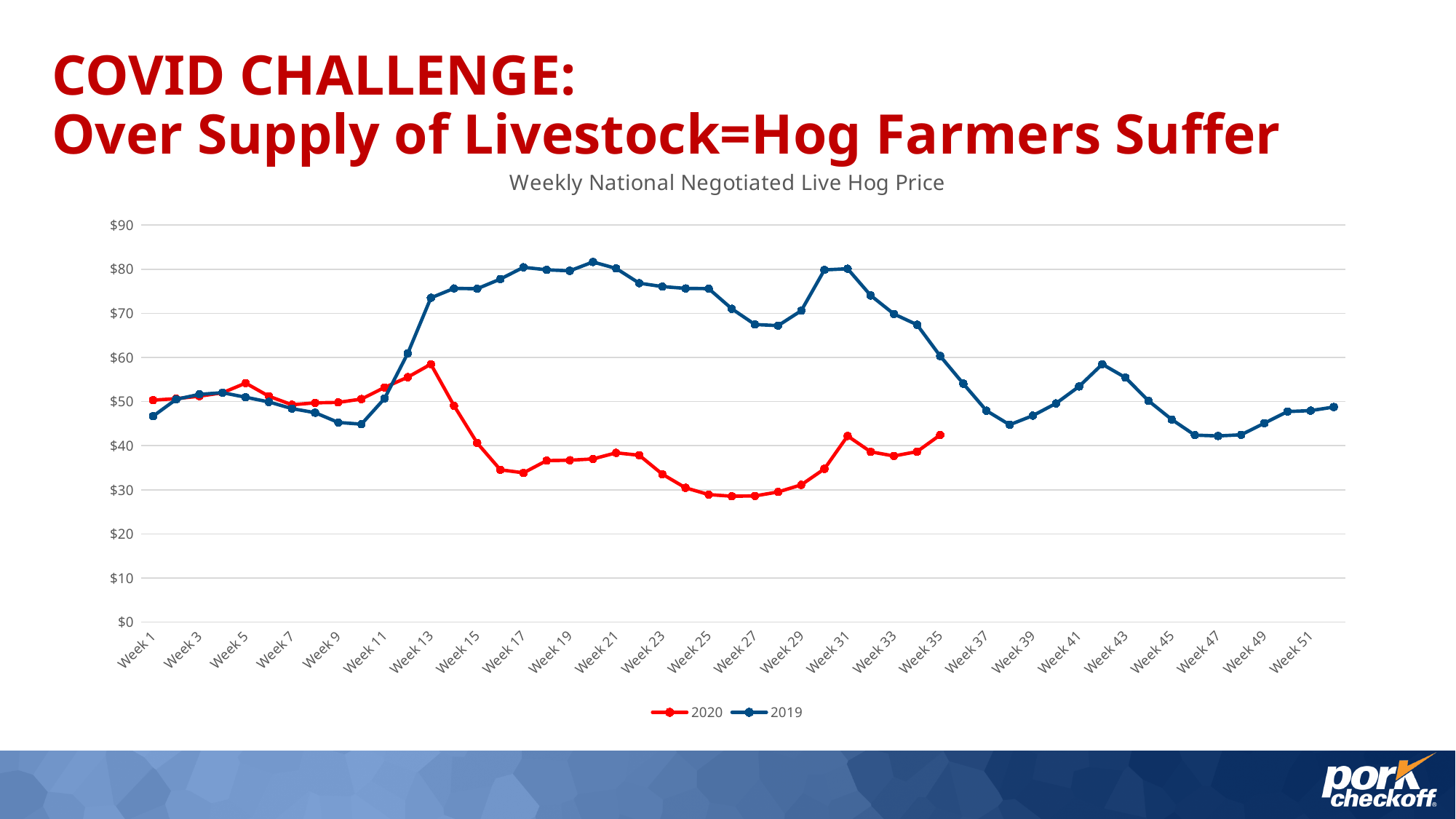
Does the 2020 series rise or fall from Week 13 to Week 17? fall Is the 2020 value at Week 13 greater or less than $60? less Which colour is used for the 2020 series? red Is the 2019 value at Week 13 greater or less than $70? greater What kind of chart is shown on the slide? line chart At Week 25, which series has the higher value, 2019 or 2020? 2019 How many series does the legend list? 2 At Week 1, which series has the higher value, 2019 or 2020? 2020 Does the 2019 series rise or fall from Week 35 to Week 39? fall Is the 2020 value at Week 27 greater or less than $30? less What is the title of the chart? Weekly National Negotiated Live Hog Price